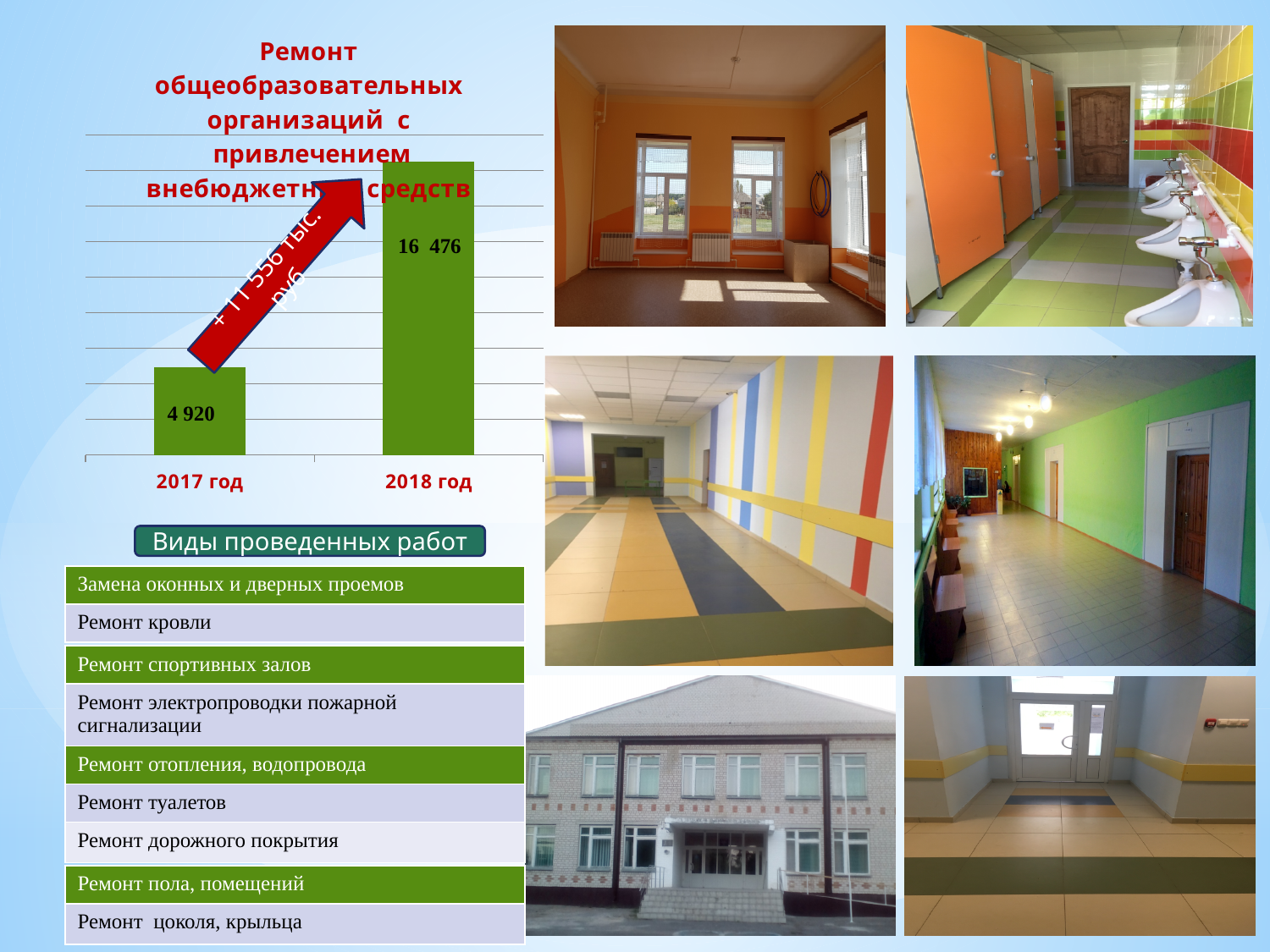
What increase does the arrow annotation on the chart state? + 11 556 тыс. руб. Which year has the higher value on the chart? 2018 год What is the difference between the values for 2018 год and 2017 год? 11 556 What is the value shown for 2017 год? 4 920 Is the value for 2018 год larger or smaller than the value for 2017 год? larger What is the value shown for 2018 год? 16 476 What colour are the bars in the chart? green How many bars (categories) does the chart show? 2 Which year has the lower value on the chart? 2017 год What type of chart is shown on the slide? bar chart Do the values rise or fall from 2017 год to 2018 год? rise